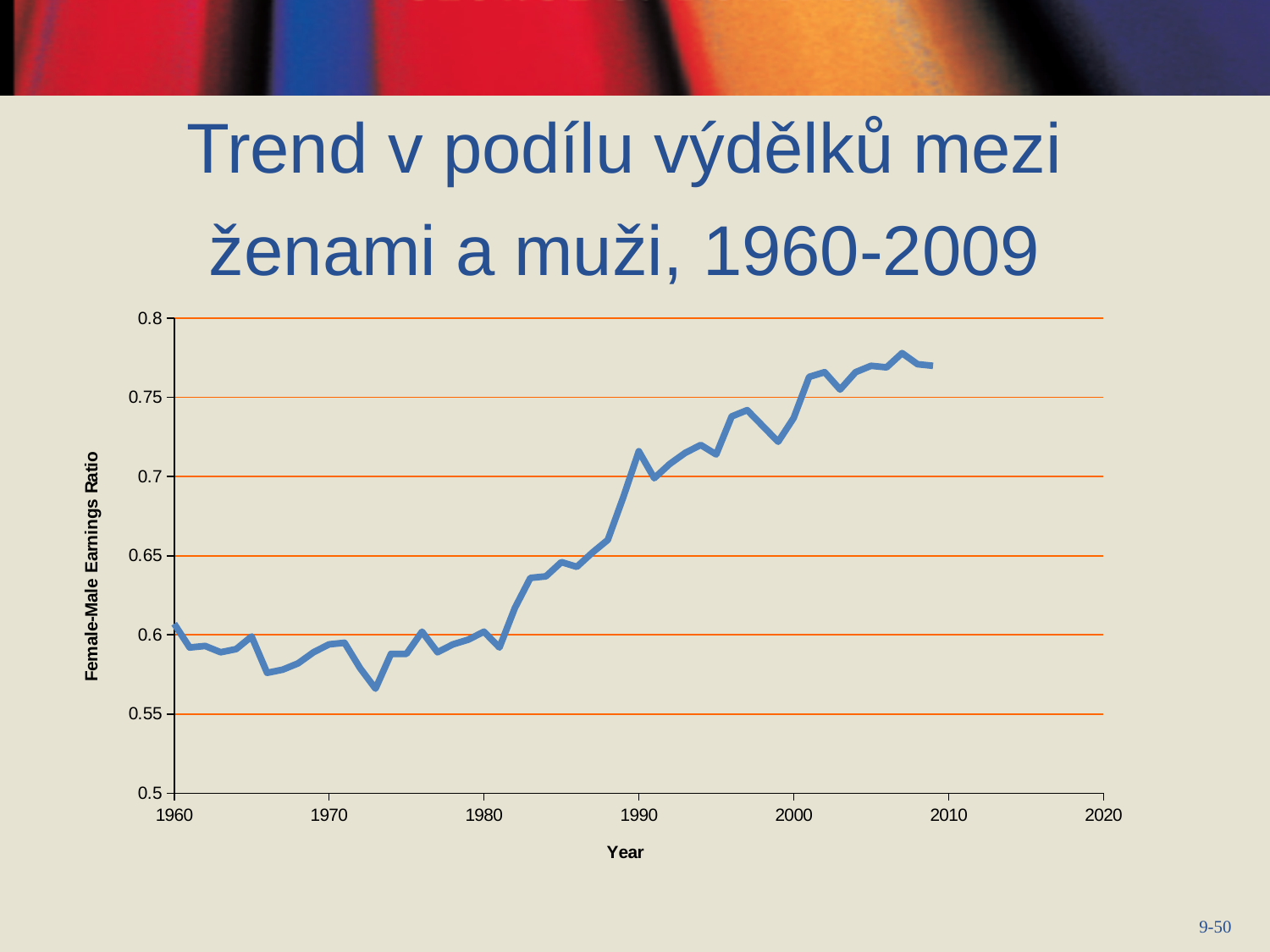
Which year has the larger Female-Male Earnings Ratio, 1980 or 2000? 2000 What is the label of the vertical axis? Female-Male Earnings Ratio What kind of chart is shown on the slide? line chart Which year has the larger Female-Male Earnings Ratio, 1970 or 1990? 1990 Is the Female-Male Earnings Ratio in 1973 greater or less than 0.55? greater Overall, does the Female-Male Earnings Ratio rise or fall from 1960 to 2009? rise Is the Female-Male Earnings Ratio in 1966 greater or less than 0.6? less Is the Female-Male Earnings Ratio in 2000 greater or less than 0.75? less What is the label of the horizontal axis? Year